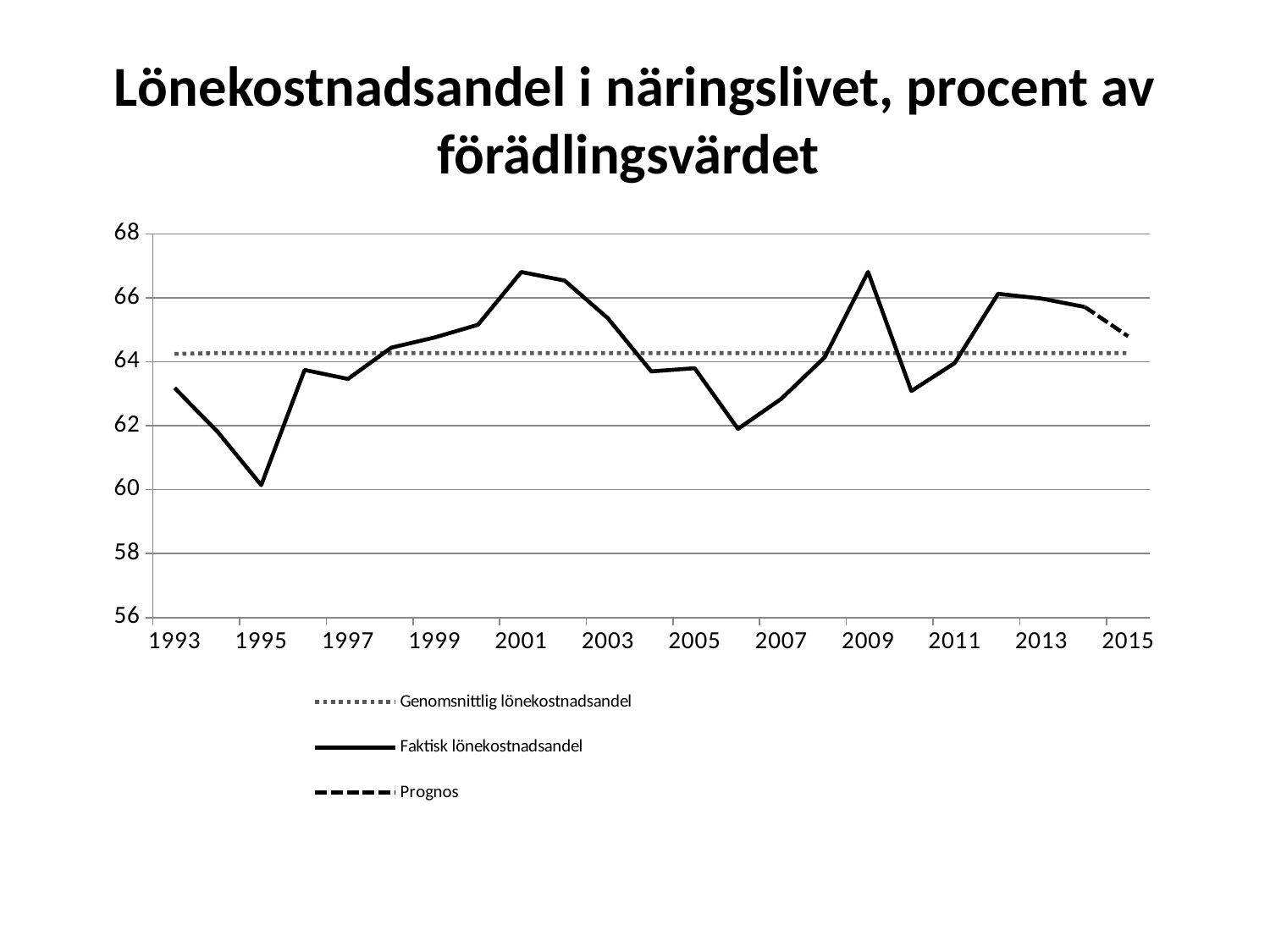
Is the value of Faktisk lönekostnadsandel in 1995 greater or less than 62? less Is the Prognos value for 2015 greater or less than 64? greater Is the value of Faktisk lönekostnadsandel in 2001 greater or less than 66? greater Which is larger, the Faktisk lönekostnadsandel in 2009 or in 2010? 2009 Does the Faktisk lönekostnadsandel rise or fall between 1993 and 1995? fall What kind of chart is shown on the slide? line chart Which is larger, the Faktisk lönekostnadsandel in 1993 or in 1995? 1993 What is the title of the chart? Lönekostnadsandel i näringslivet, procent av förädlingsvärdet How many series does the legend list? 3 Which series is drawn with a dashed line according to the legend? Prognos In which year is the Faktisk lönekostnadsandel at its lowest? 1995